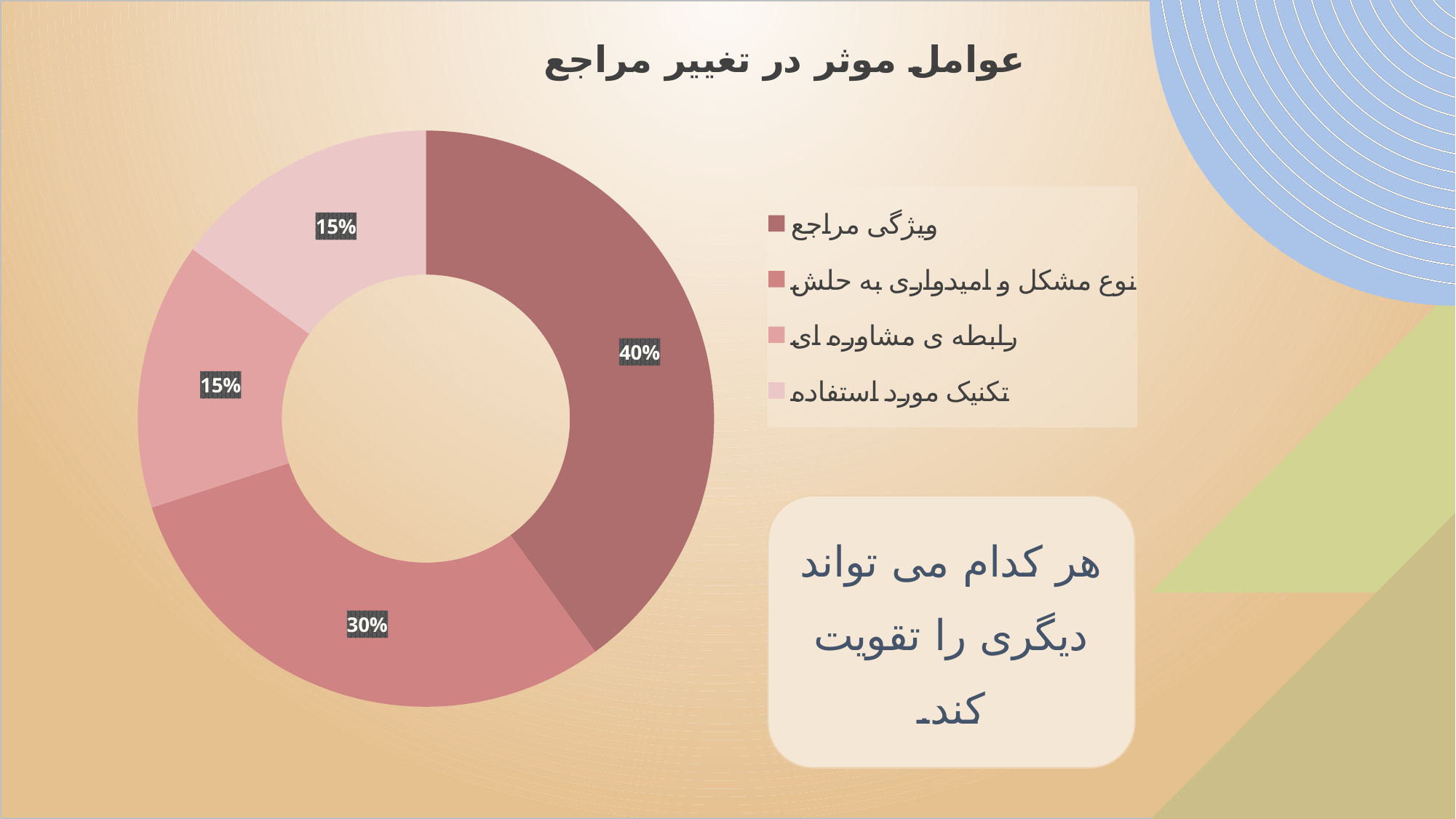
What percentage is shown for نوع مشکل و امیدواری به حلش? 30% What percentage is shown for تکنیک مورد استفاده? 15% What is the difference between the shares of ویژگی مراجع and نوع مشکل و امیدواری به حلش? 10% What is the title of the chart? عوامل موثر در تغییر مراجع How many entries does the legend list? 4 What percentage is shown for رابطه ی مشاوره ای? 15% Which category has the largest share of the chart? ویژگی مراجع Which two categories share the smallest value in the chart? رابطه ی مشاوره ای and تکنیک مورد استفاده What percentage is shown for ویژگی مراجع? 40% What kind of chart is shown on the slide? Doughnut (pie) chart How many categories does the chart show? 4 Which is larger, the share for نوع مشکل و امیدواری به حلش or the share for تکنیک مورد استفاده? نوع مشکل و امیدواری به حلش